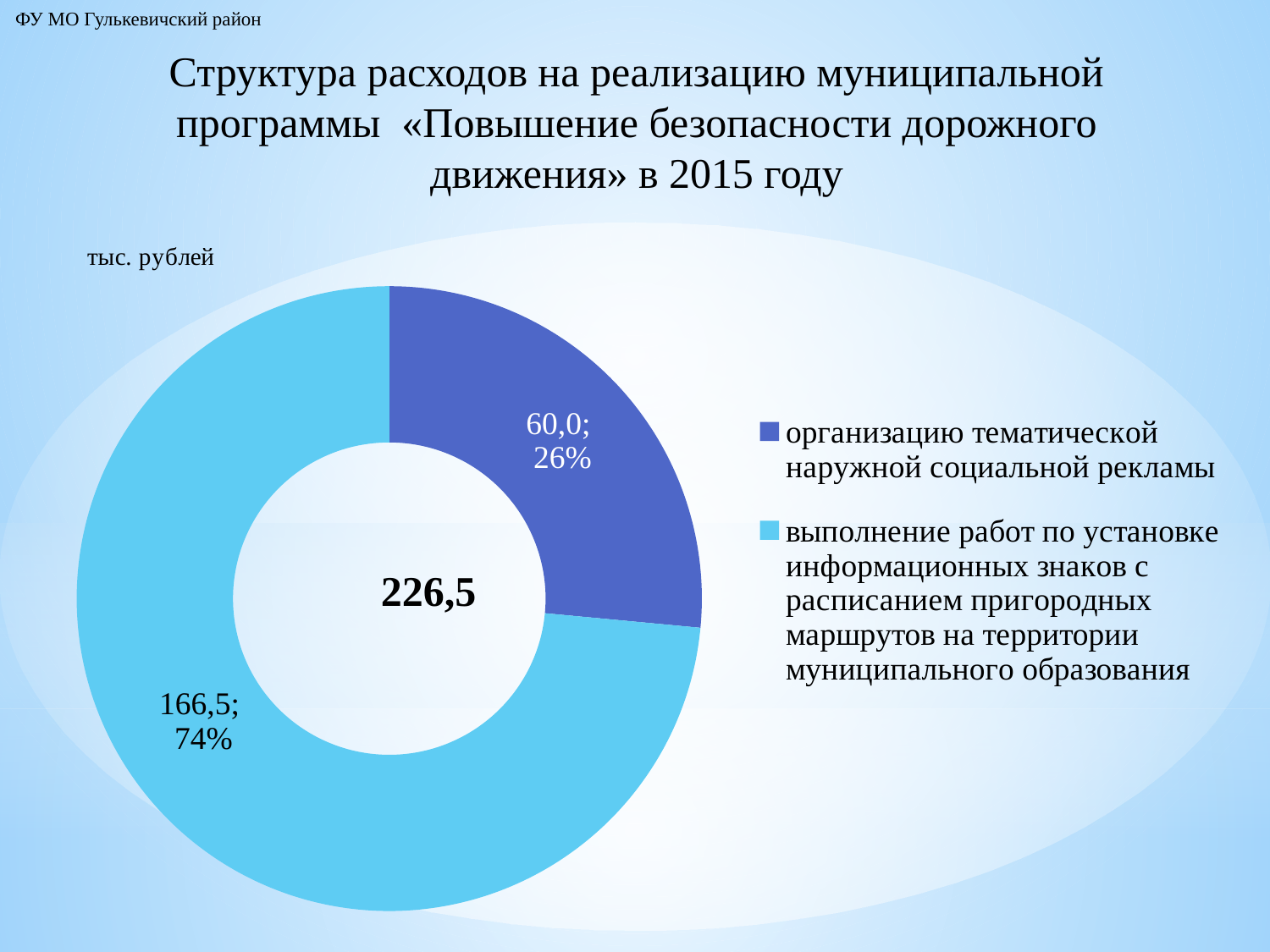
Which category has the largest value? выполнение работ по установке информационных знаков с расписанием пригородных маршрутов на территории муниципального образования What is the value for «выполнение работ по установке информационных знаков с расписанием пригородных маршрутов на территории муниципального образования»? 166,5 How many categories does the chart show? 2 Which category has the smallest value? организацию тематической наружной социальной рекламы What kind of chart is shown on the slide? Doughnut (pie) chart What total is shown in the centre of the chart? 226,5 What share of the chart does «организацию тематической наружной социальной рекламы» take? 26% What is the value for «организацию тематической наружной социальной рекламы»? 60,0 What share of the chart does «выполнение работ по установке информационных знаков» take? 74% What unit is indicated for the chart values? тыс. рублей Which is larger: the value for «организацию тематической наружной социальной рекламы» or for «выполнение работ по установке информационных знаков»? выполнение работ по установке информационных знаков What is the difference between the values for «выполнение работ по установке информационных знаков» and «организацию тематической наружной социальной рекламы»? 106,5